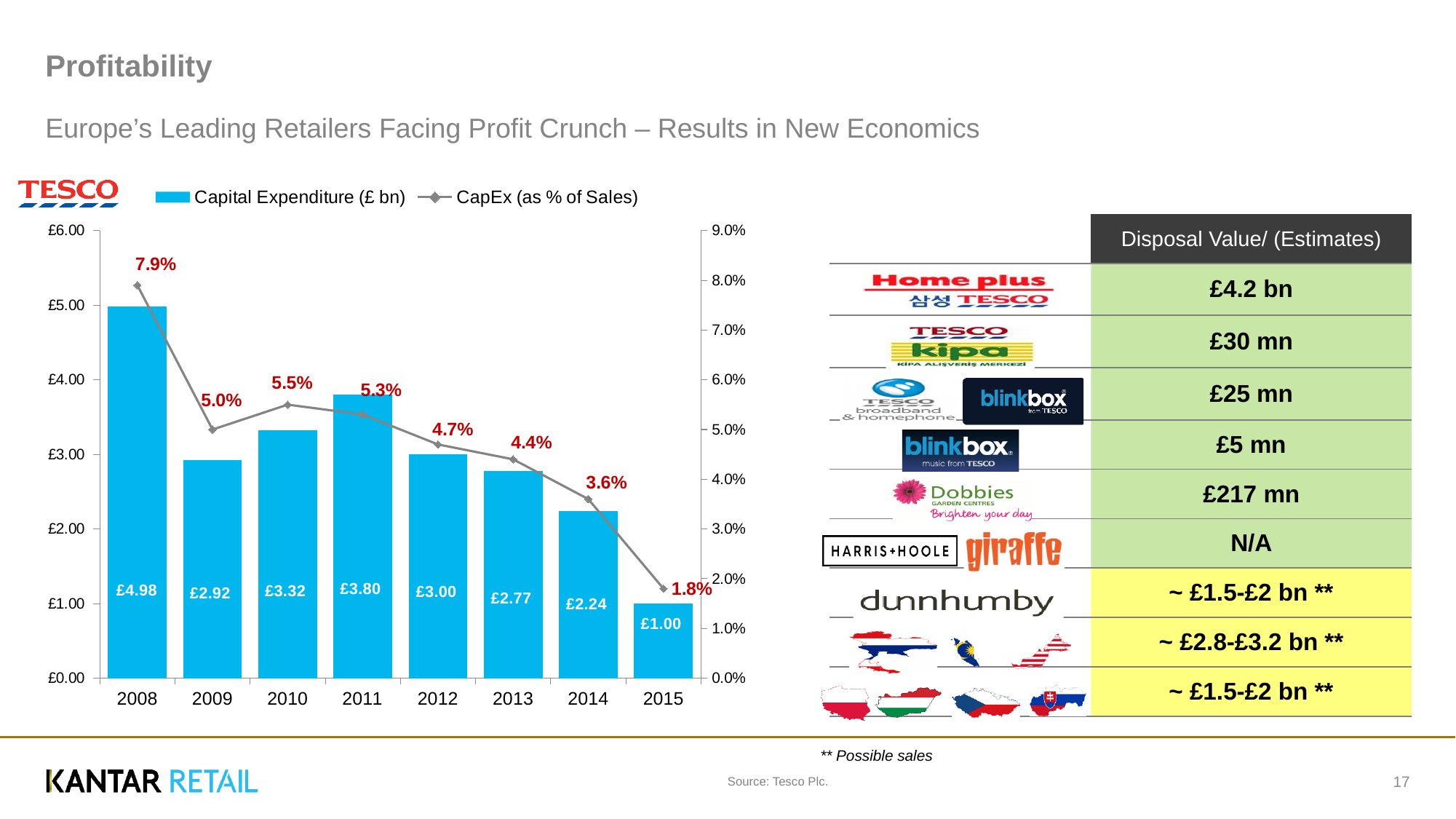
Does CapEx as a % of Sales generally rise or fall from 2008 to 2015? Fall What is the difference in Capital Expenditure between 2008 and 2015? £3.98 Which year had the lowest CapEx as a % of Sales? 2015 Which year had the highest Capital Expenditure? 2008 What was CapEx as a % of Sales in 2013? 4.4% Which year had higher Capital Expenditure, 2010 or 2012? 2010 How many series does the chart legend list? 2 What kind of chart is used to show Capital Expenditure and CapEx as % of Sales? Combined bar and line chart Is the Capital Expenditure for 2014 greater or less than £2.00? greater How many years are shown on the x axis of the chart? 8 What colour are the Capital Expenditure bars in the chart? Blue What was Tesco's Capital Expenditure (£ bn) in 2011? £3.80